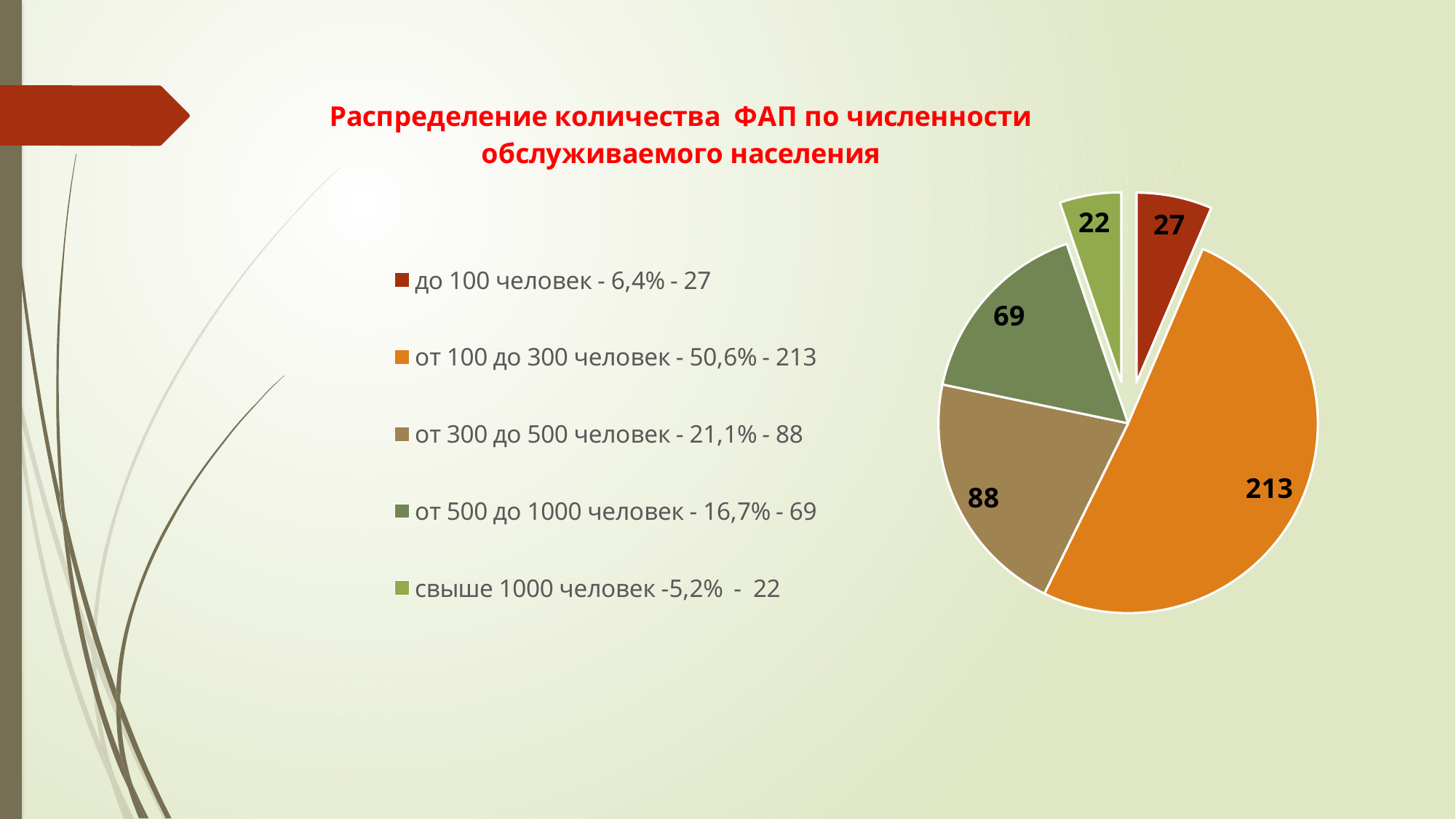
Which is larger: the value for 'до 100 человек' or for 'свыше 1000 человек'? до 100 человек What share of the pie does the slice 'от 300 до 500 человек' represent, as printed in the legend? 21,1% How many slices does the pie chart have? 5 What is the value for the slice 'до 100 человек'? 27 What is the difference between the values for 'от 300 до 500 человек' and 'от 500 до 1000 человек'? 19 What kind of chart is shown on the slide? pie chart Which category has the smallest slice? свыше 1000 человек Which category has the largest slice? от 100 до 300 человек What share of the pie does the slice 'от 100 до 300 человек' represent, as printed in the legend? 50,6% What is the value for the slice 'от 100 до 300 человек'? 213 What is the value for the slice 'от 500 до 1000 человек'? 69 What colour is the slice for 'от 100 до 300 человек'? orange